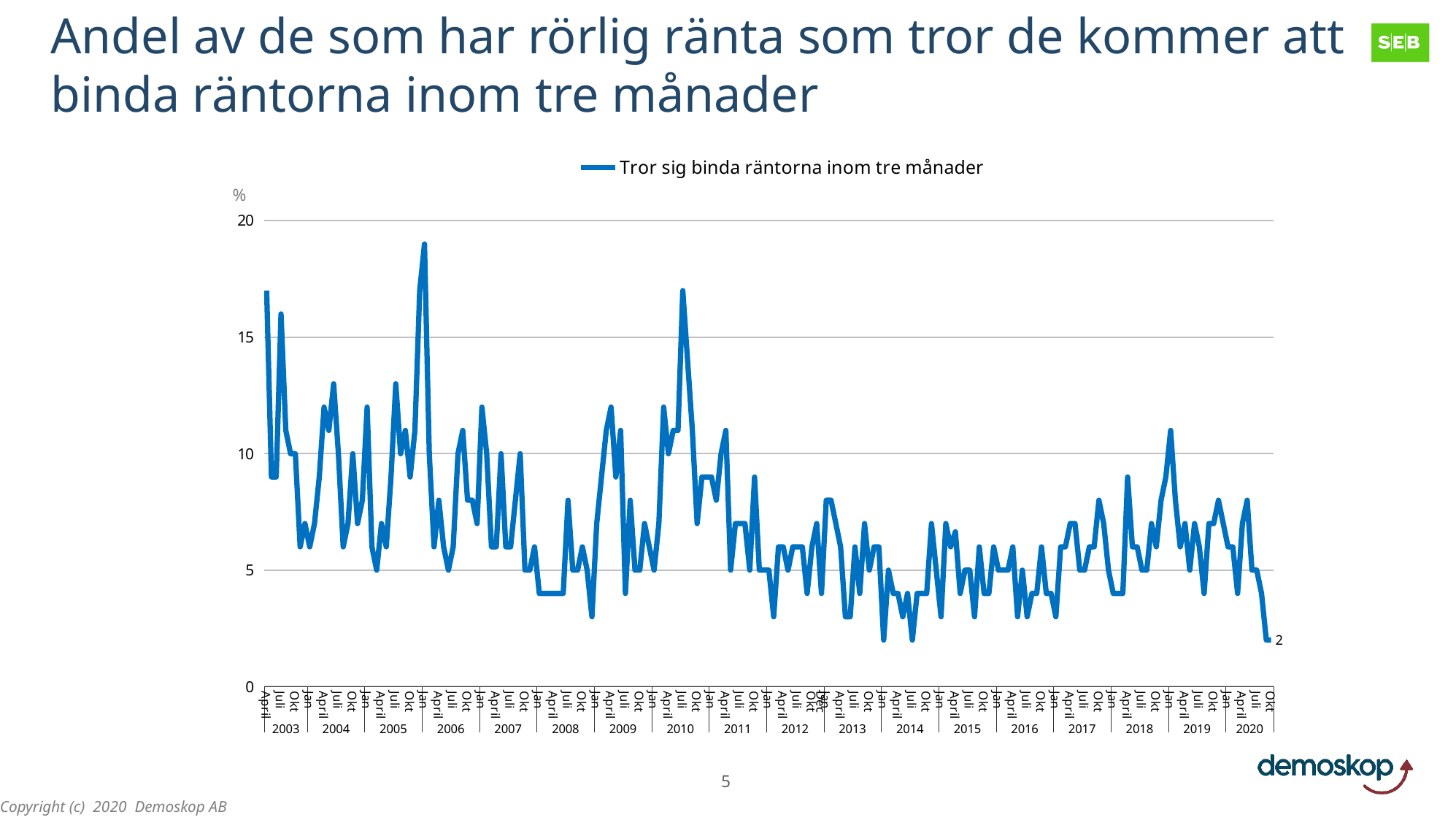
What is the legend entry for the plotted series? Tror sig binda räntorna inom tre månader Is the peak value in mid-2010 greater or less than 15? greater Overall, do the values rise or fall from 2003 to 2020? fall Is the value at the start of the series (April 2003) greater or less than 15? greater What unit is shown at the top of the y axis? % In which year does the line reach its highest value? 2006 What is the value of the last data point (Okt 2020), as labelled on the chart? 2 Is the value for Okt 2020 greater or less than 5? less What kind of chart is shown on the slide? line chart How many series does the legend list? 1 How many years are labelled along the x axis? 18